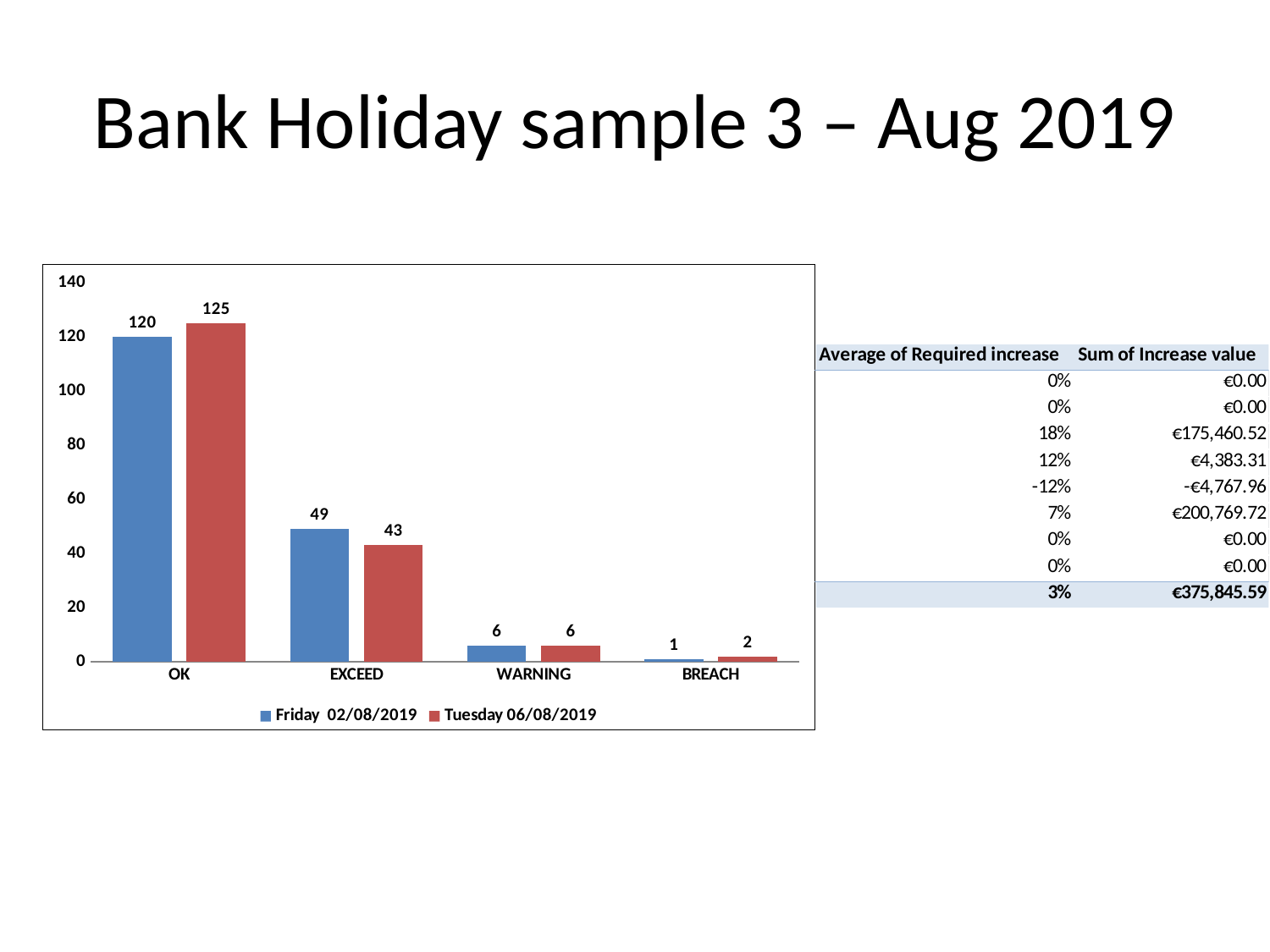
What is the difference between the Friday 02/08/2019 and Tuesday 06/08/2019 values for EXCEED? 6 Which category has the highest value in the Tuesday 06/08/2019 series? OK Which category has the lowest value in the Friday 02/08/2019 series? BREACH What is the value for OK in the Friday 02/08/2019 series? 120 What is the difference between the Tuesday 06/08/2019 and Friday 02/08/2019 values for OK? 5 How many series does the chart legend list? 2 What is the value for EXCEED in the Tuesday 06/08/2019 series? 43 Is the value for OK in the Tuesday 06/08/2019 series greater or less than 100? greater Which is larger for EXCEED: the Friday 02/08/2019 value or the Tuesday 06/08/2019 value? Friday 02/08/2019 How many categories are shown on the x axis of the chart? 4 What kind of chart is shown on the slide? bar chart What is the value for BREACH in the Tuesday 06/08/2019 series? 2